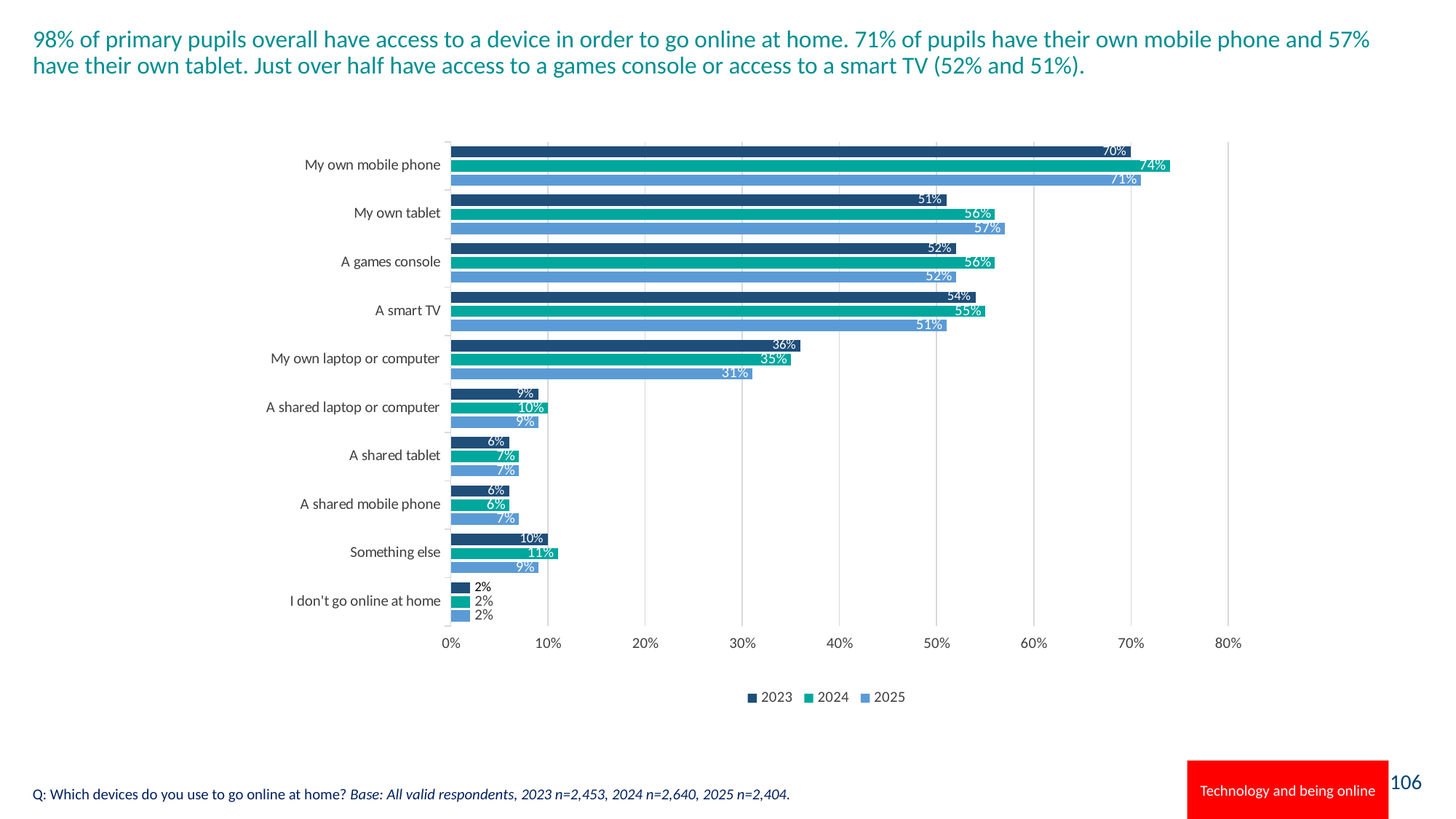
How many device categories are shown on the chart? 10 Which years are listed in the chart legend? 2023, 2024, 2025 What was the value for 'My own tablet' in 2023? 51% How many series does the legend list? 3 What is the difference between the 2024 and 2025 values for 'My own mobile phone'? 3 percentage points What type of chart is shown on the slide? Bar chart Which device category has the highest value in 2024? My own mobile phone What percentage of pupils said they use their own mobile phone to go online at home in 2025? 71% Which is larger for 'A smart TV': the 2023 value or the 2025 value? 2023 Which category has the lowest value in 2025? I don't go online at home Did the value for 'My own laptop or computer' rise or fall from 2023 to 2025? Fall What percentage of pupils used a games console to go online at home in 2024? 56%